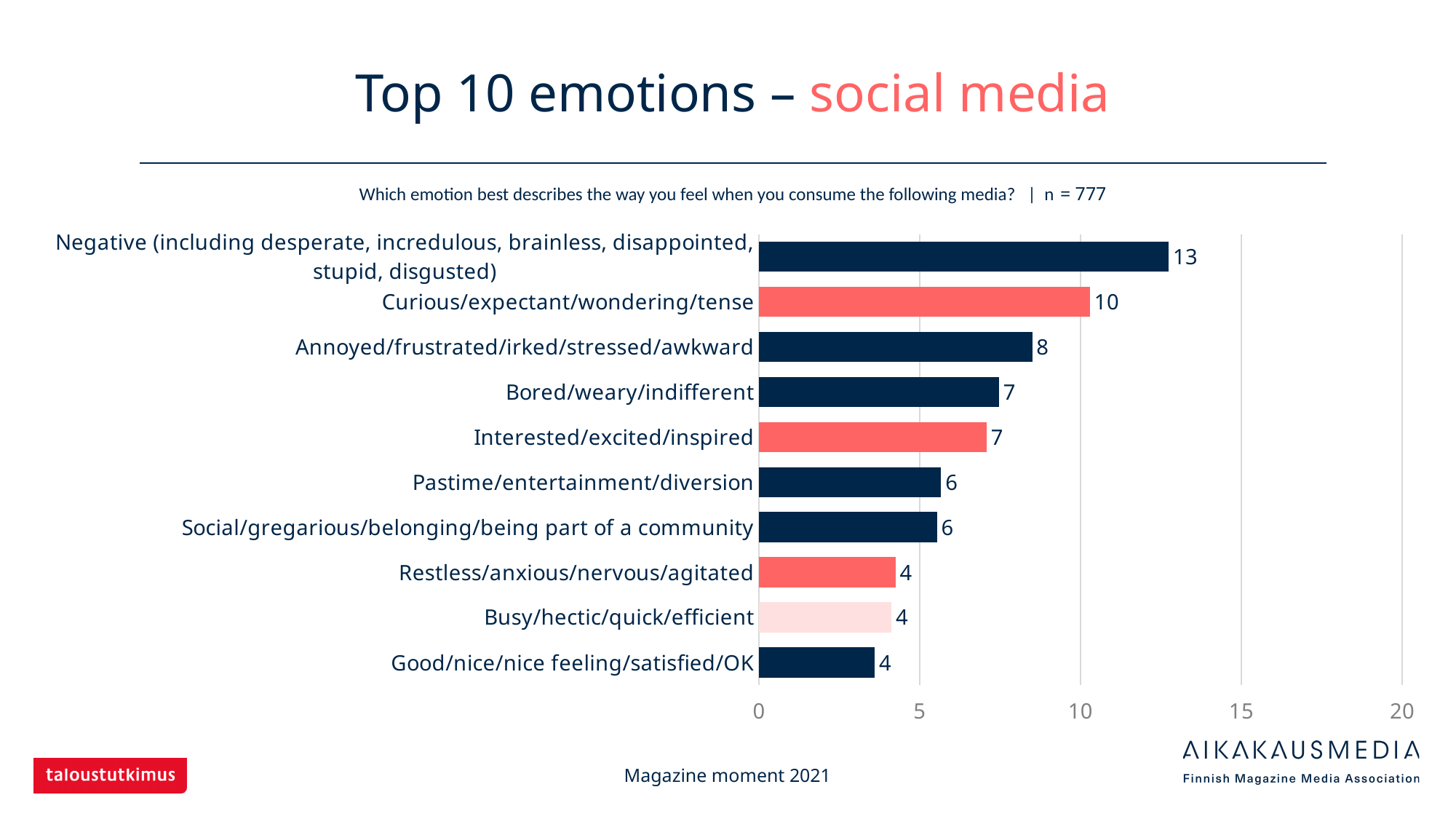
Which emotion category has the highest value? Negative (including desperate, incredulous, brainless, disappointed, stupid, disgusted) What is the value for Bored/weary/indifferent? 7 What is the difference between the values for Annoyed/frustrated/irked/stressed/awkward and Restless/anxious/nervous/agitated? 4 How many emotion categories are shown in the chart? 10 What kind of chart is shown on the slide? Bar chart Is the value for Negative greater or less than 10? greater What is the value for Pastime/entertainment/diversion? 6 What is the sample size (n) stated on the slide? 777 What is the value for Curious/expectant/wondering/tense? 10 Which is larger, the value for Annoyed/frustrated/irked/stressed/awkward or the value for Social/gregarious/belonging/being part of a community? Annoyed/frustrated/irked/stressed/awkward What is the title of the chart? Top 10 emotions – social media What is the difference between the values for Negative and Curious/expectant/wondering/tense? 3